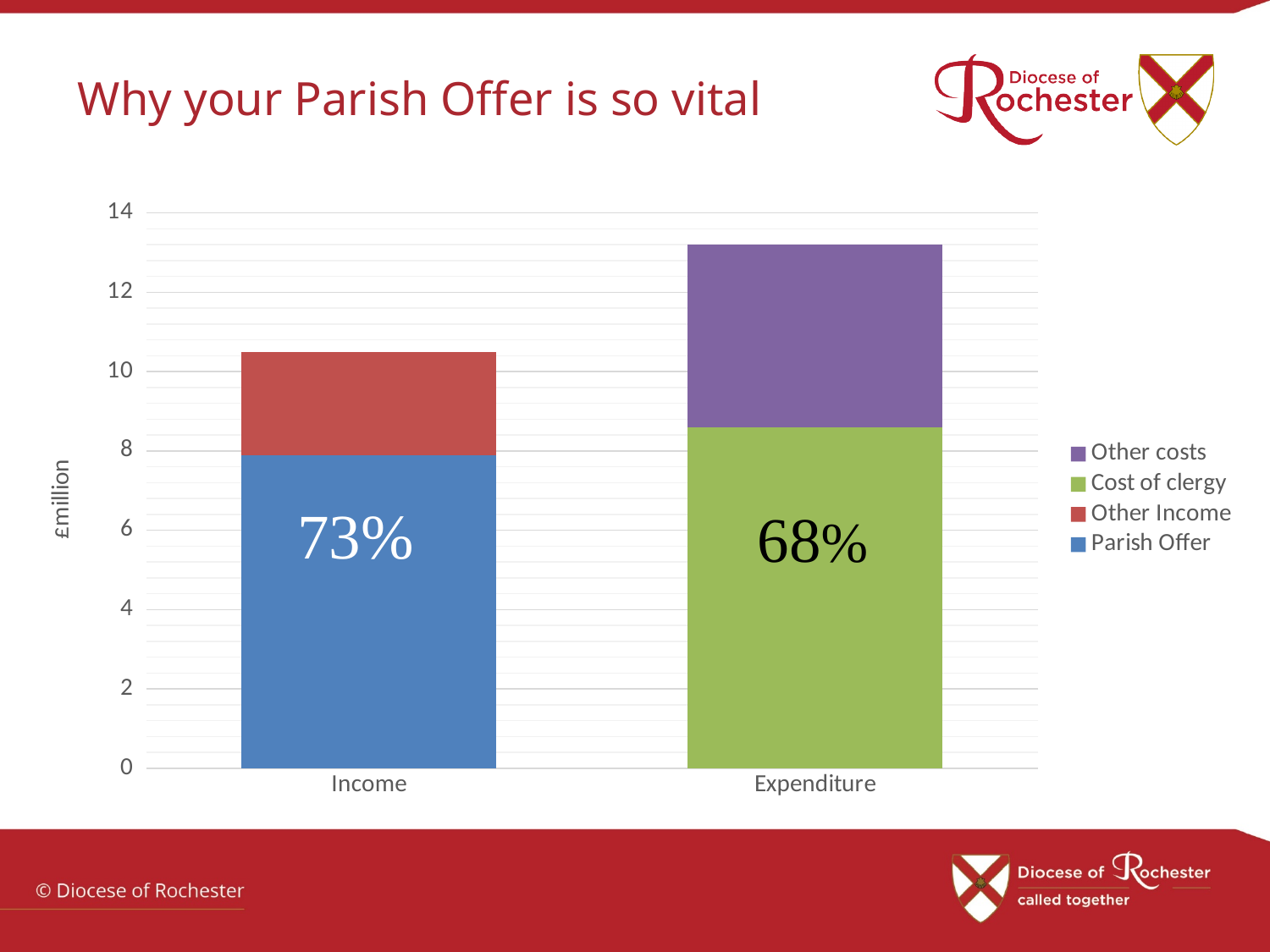
Which legend entry is shown in purple? Other costs Which category has the taller stacked bar, Income or Expenditure? Expenditure What percentage label is printed on the Cost of clergy segment of the Expenditure bar? 68% What percentage label is printed on the Parish Offer segment of the Income bar? 73% What kind of chart is shown on the slide? Stacked bar chart What is the label on the y axis? £million Is the total of the Income bar greater or less than 12? less How many series does the legend list? 4 Is the value for Cost of clergy greater or less than 8? greater Is the total of the Expenditure bar greater or less than 12? greater How many categories are shown on the x axis? 2